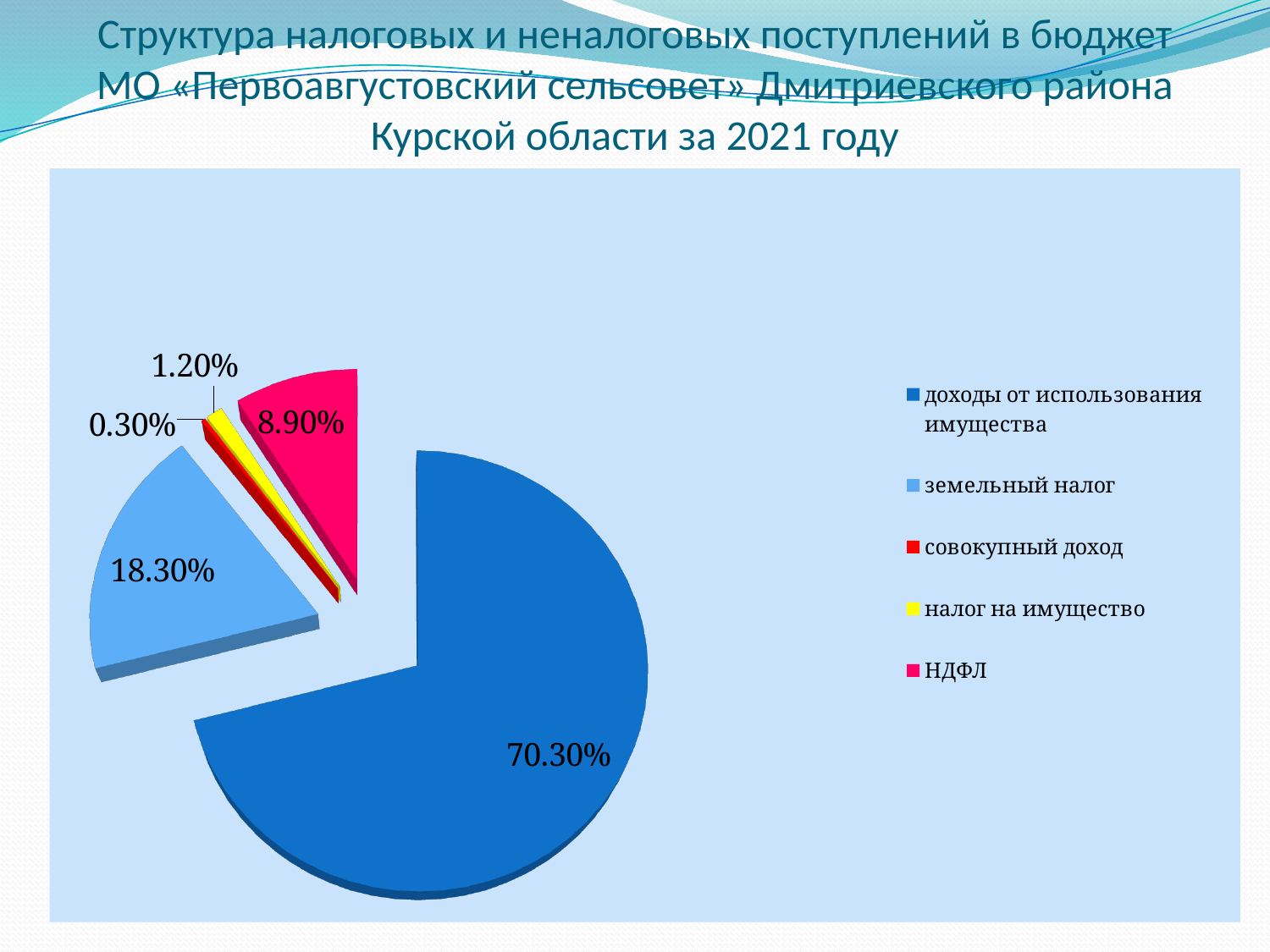
What is the difference between the shares of «земельный налог» and «НДФЛ»? 9.40% What is the value shown for «налог на имущество»? 1.20% Which is larger, the share of «НДФЛ» or the share of «налог на имущество»? НДФЛ How many categories does the pie chart have? 5 What is the value shown for «НДФЛ»? 8.90% Which category has the largest slice of the pie? доходы от использования имущества Which category has the smallest slice of the pie? совокупный доход What colour is the slice for «земельный налог»? light blue What share of the pie does «доходы от использования имущества» have? 70.30% What type of chart is shown on the slide? pie chart What is the value shown for «совокупный доход»? 0.30% What is the value shown for «земельный налог»? 18.30%